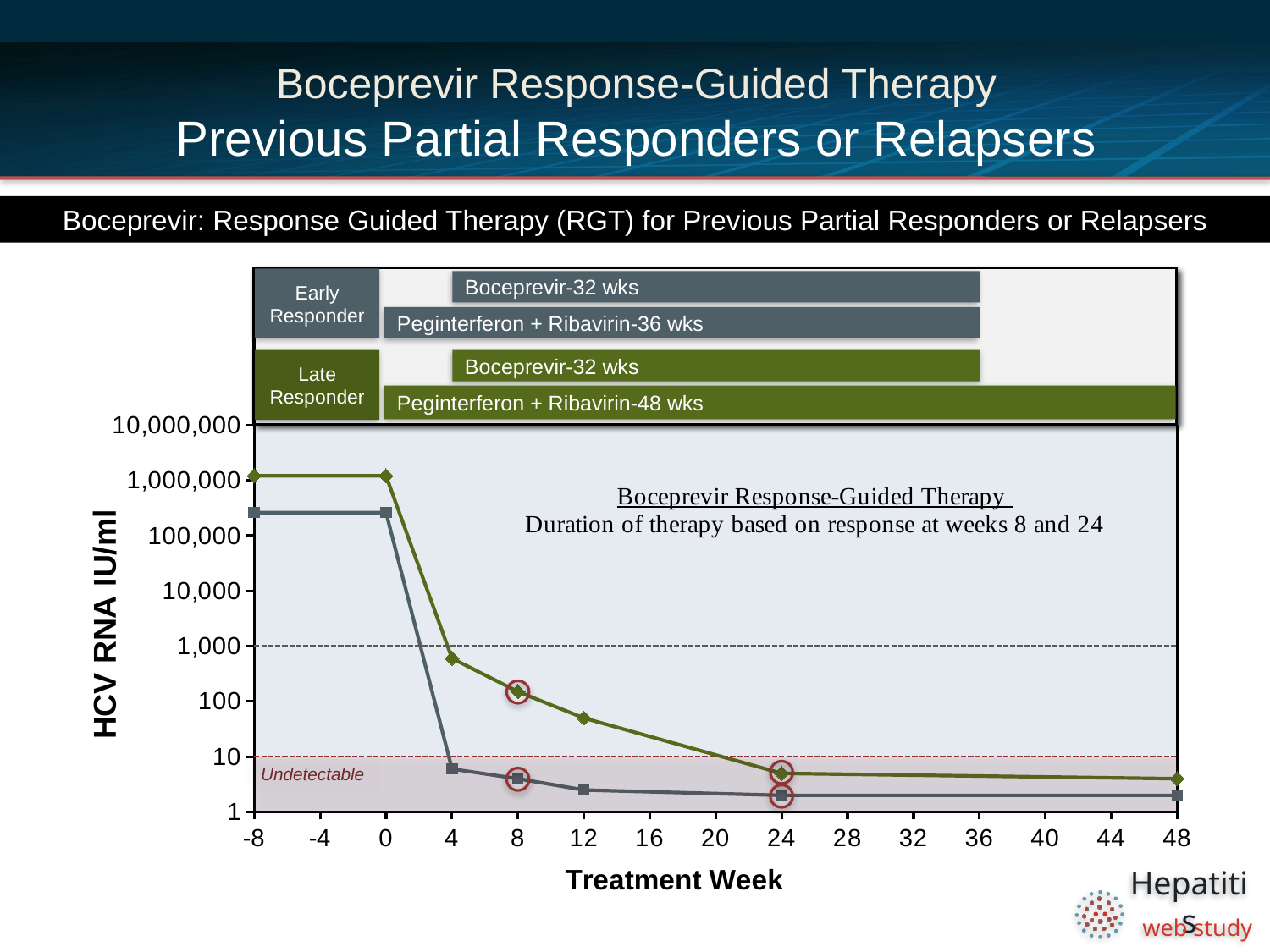
How many tick marks are labelled on the Treatment Week axis? 15 How many series are plotted on the chart? 2 Is the Early Responder value at treatment week 4 greater or less than 10? less Do the HCV RNA values for the Late Responder series rise or fall from week 0 to week 24? fall At treatment week 8, which series has the higher HCV RNA value, Early Responder or Late Responder? Late Responder What is the label of the y axis? HCV RNA IU/ml Is the Late Responder value at treatment week 4 greater or less than 1,000? less What is the label of the x axis? Treatment Week Is the Early Responder value at treatment week 0 greater or less than 100,000? greater What kind of chart is shown on the slide? line chart